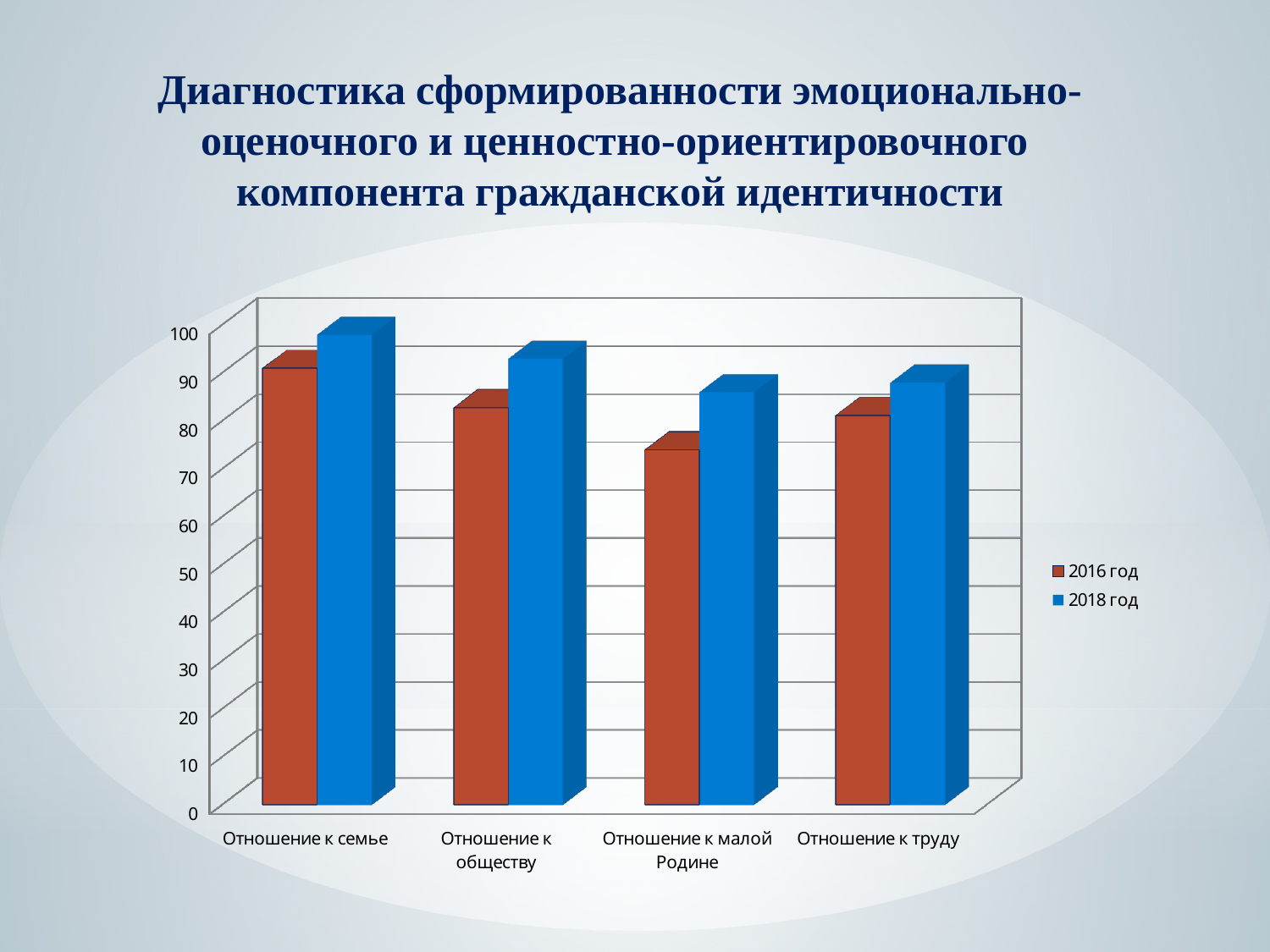
Which series is shown in blue in the legend? 2018 год Is the value for Отношение к малой Родине in 2018 год greater or less than 80? greater For Отношение к труду, which series has the larger value, 2016 год or 2018 год? 2018 год What kind of chart is shown on the slide? bar chart For Отношение к обществу, which series has the larger value, 2016 год or 2018 год? 2018 год How many categories are shown on the x axis? 4 Which category has the highest value for 2016 год? Отношение к семье How many series does the legend list? 2 Which category has the lowest value for 2018 год? Отношение к малой Родине Is the value for Отношение к семье in 2018 год greater or less than 90? greater Which category has the lowest value for 2016 год? Отношение к малой Родине Is the value for Отношение к малой Родине in 2016 год greater or less than 80? less